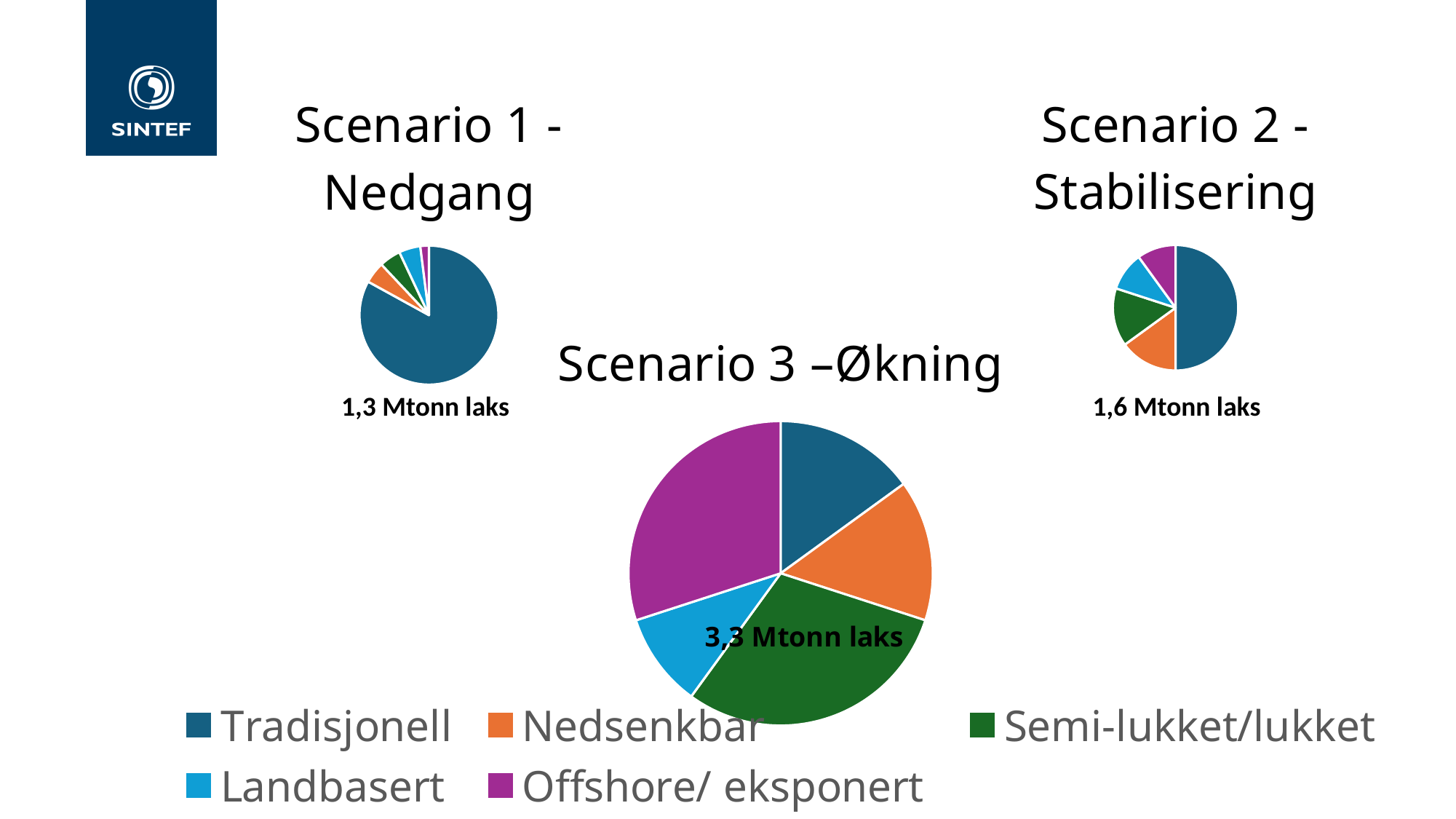
How many categories does the legend list for the pie charts? 5 What total volume label is shown under the Scenario 1 - Nedgang pie chart? 1,3 Mtonn laks How many pie charts are shown on the slide? 3 Which scenario has the largest total volume of salmon? Scenario 3 – Økning In the Scenario 3 – Økning pie chart, which category has the smallest slice? Landbasert Which scenario has the smallest total volume of salmon? Scenario 1 - Nedgang What total volume label is shown on the Scenario 3 – Økning pie chart? 3,3 Mtonn laks In the Scenario 2 - Stabilisering pie chart, which category has the largest slice? Tradisjonell In the Scenario 1 - Nedgang pie chart, which category has the largest slice? Tradisjonell In the Scenario 3 – Økning pie chart, which slice is larger: Offshore/ eksponert or Tradisjonell? Offshore/ eksponert What kind of chart is used for Scenario 1 - Nedgang? Pie chart What total volume label is shown for the Scenario 2 - Stabilisering pie chart? 1,6 Mtonn laks